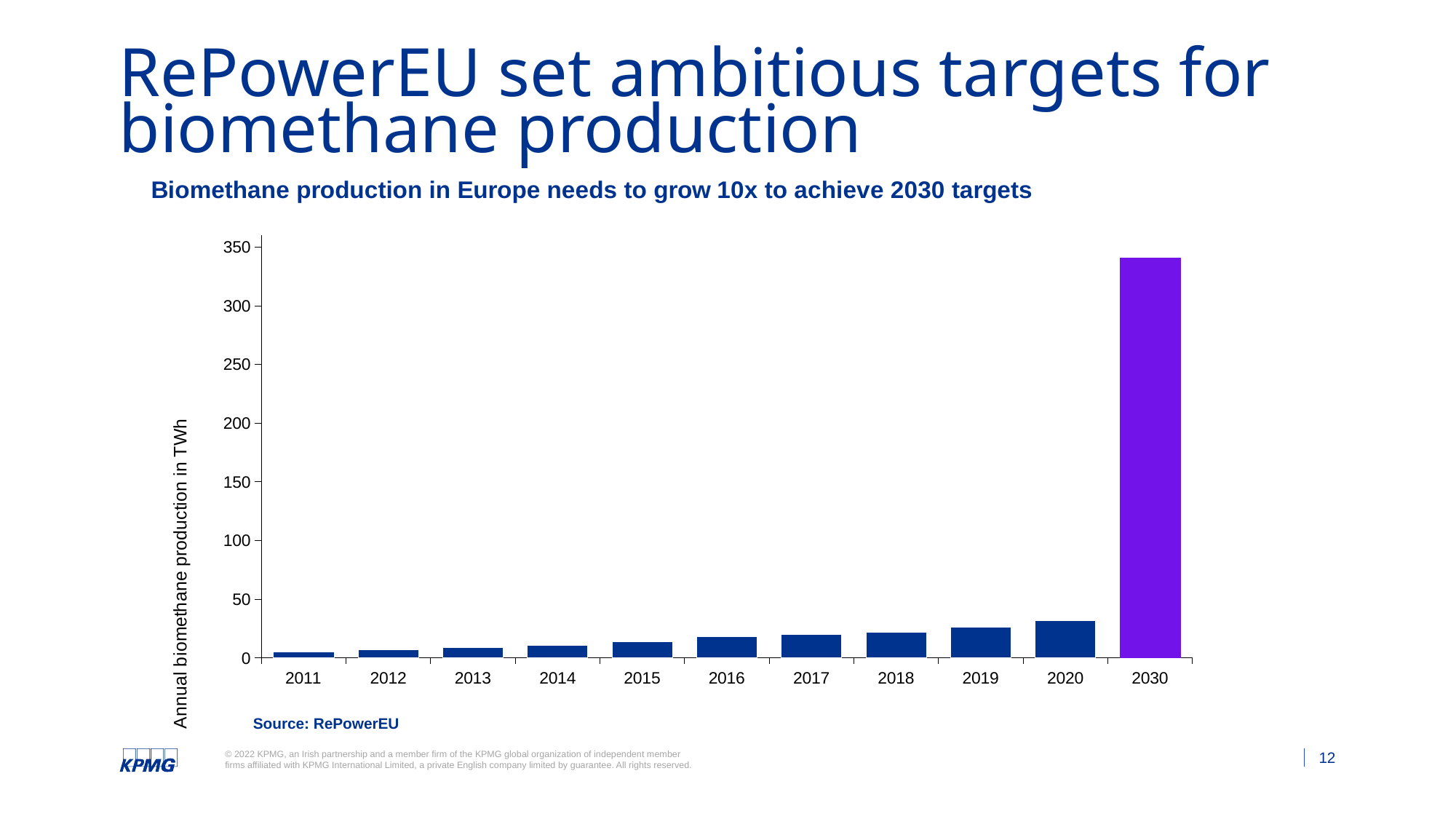
Do the values rise or fall from 2011 to 2030 along the x axis? rise What kind of chart is shown on the slide? bar chart Which year has the lowest annual biomethane production in the chart? 2011 What source is cited below the chart? RePowerEU Which year has the highest annual biomethane production in the chart? 2030 How many years are shown on the x axis of the chart? 11 Is the value for 2015 greater or less than 50? less Which is larger, the value for 2020 or the value for 2011? 2020 Is the value for 2020 greater or less than 50? less Is the value for 2030 greater or less than 300? greater What is the label on the y axis of the chart? Annual biomethane production in TWh